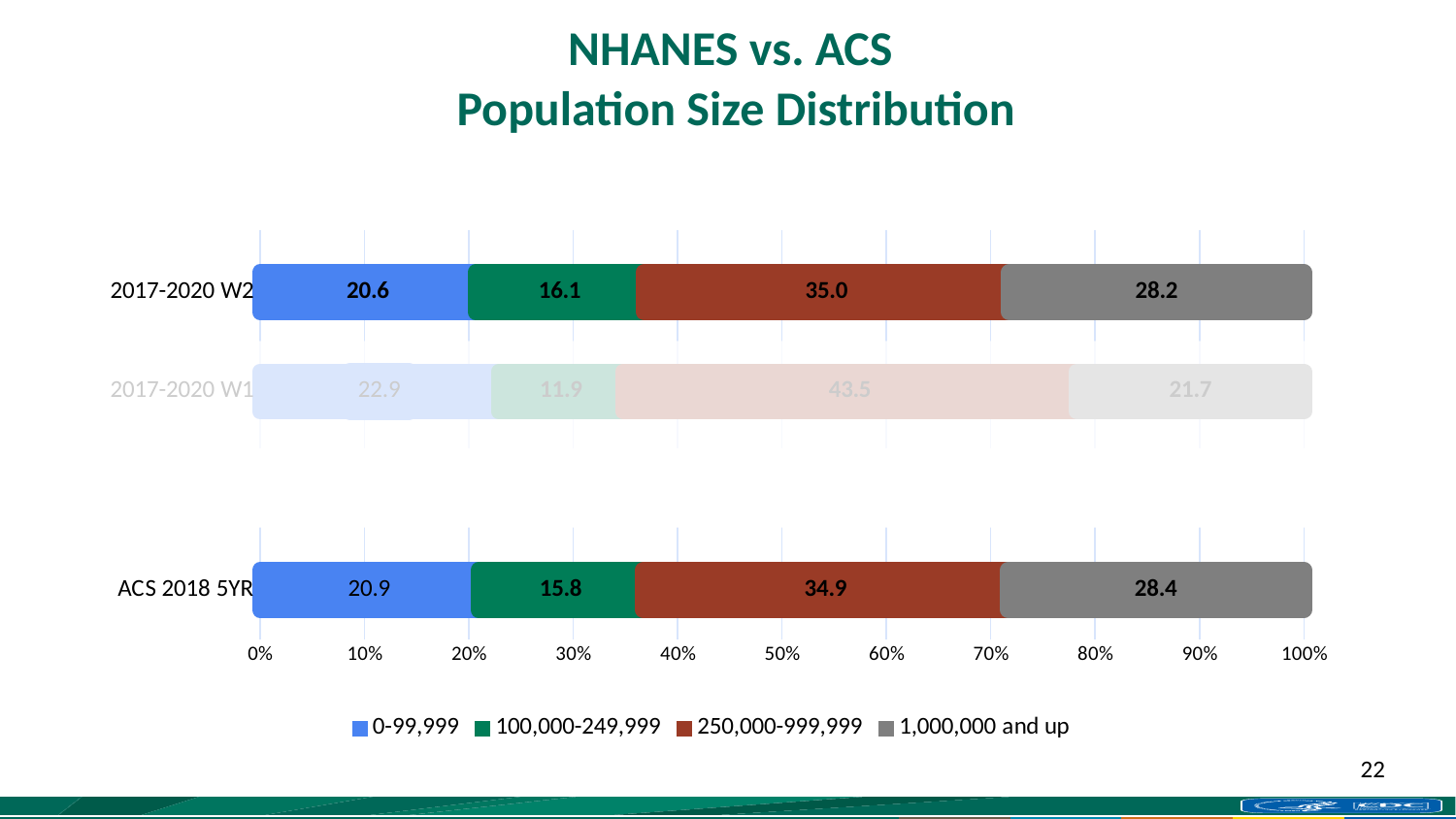
What is the value for the 0-99,999 series in the 2017-2020 W2 bar? 20.6 What is the difference between the 250,000-999,999 values for 2017-2020 W1 and 2017-2020 W2? 8.5 Which series has the smallest value in the ACS 2018 5YR bar? 100,000-249,999 Which series has the largest value in the 2017-2020 W1 bar? 250,000-999,999 What is the title of the chart on the slide? NHANES vs. ACS Population Size Distribution Which is larger: the 0-99,999 value for 2017-2020 W1 or for ACS 2018 5YR? 2017-2020 W1 What kind of chart is shown on the slide? Stacked bar chart What is the value for the 1,000,000 and up series in the 2017-2020 W1 bar? 21.7 What is the value for the 100,000-249,999 series in the 2017-2020 W1 bar? 11.9 What is the value for the 250,000-999,999 series in the ACS 2018 5YR bar? 34.9 How many series does the legend list? 4 How many bars (categories) are shown in the chart? 3